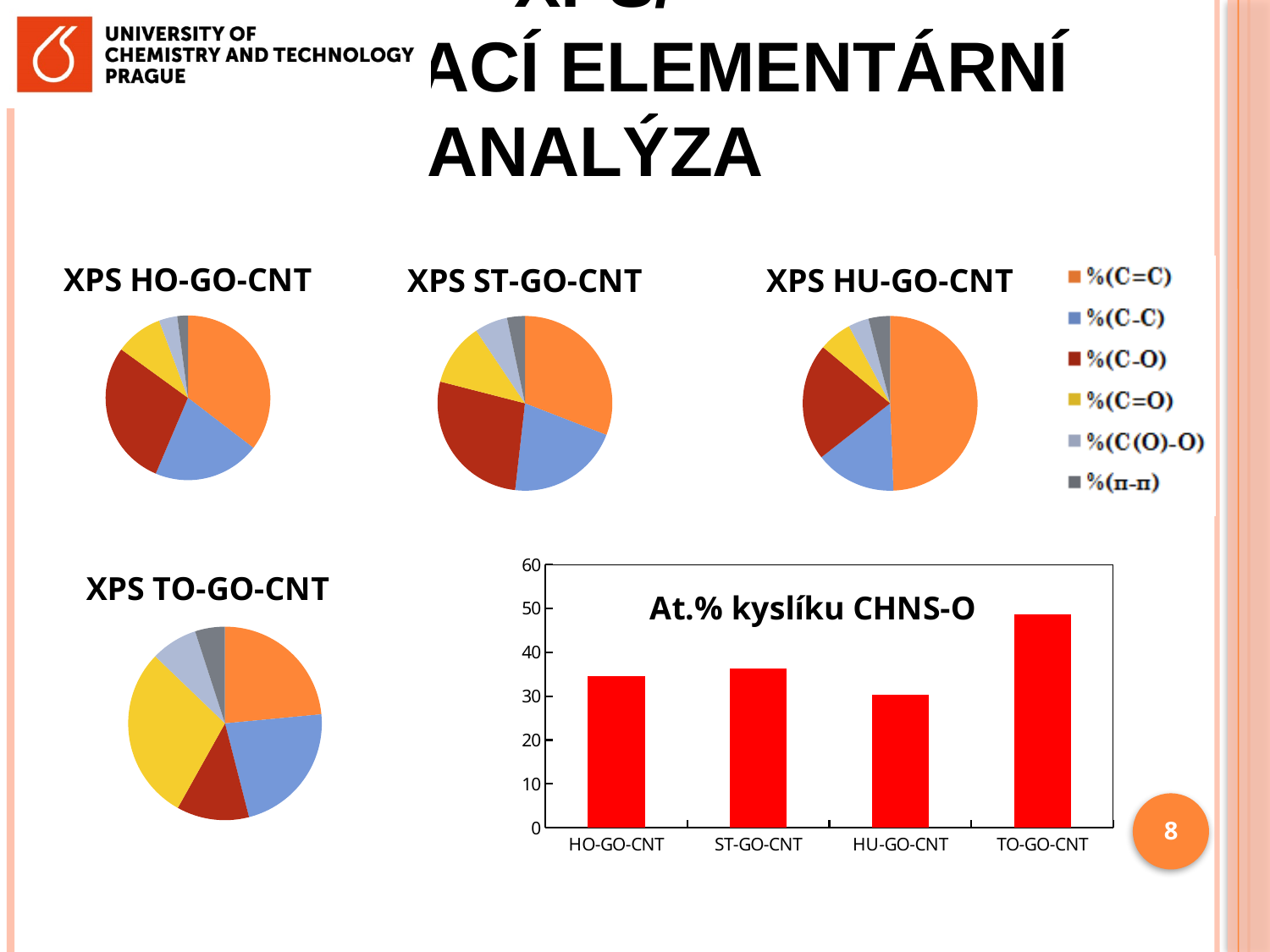
How many entries does the legend shared by the XPS pie charts list? 6 In the 'At.% kyslíku CHNS-O' chart, is the value for HO-GO-CNT greater or less than 30? greater In the 'At.% kyslíku CHNS-O' chart, which category has the lowest value? HU-GO-CNT In the 'XPS HU-GO-CNT' pie chart, which component has the largest slice? %(C=C) What kind of chart is 'XPS HU-GO-CNT'? pie chart How many pie charts are shown on the slide? 4 What kind of chart is the 'At.% kyslíku CHNS-O' chart? bar chart In the 'At.% kyslíku CHNS-O' chart, is the value for TO-GO-CNT greater or less than 40? greater In the 'At.% kyslíku CHNS-O' chart, is the value for HU-GO-CNT greater or less than 40? less In the 'At.% kyslíku CHNS-O' chart, which category has the highest value? TO-GO-CNT How many categories are shown on the x axis of the 'At.% kyslíku CHNS-O' chart? 4 In the 'At.% kyslíku CHNS-O' chart, which is larger, the value for ST-GO-CNT or the value for HU-GO-CNT? ST-GO-CNT